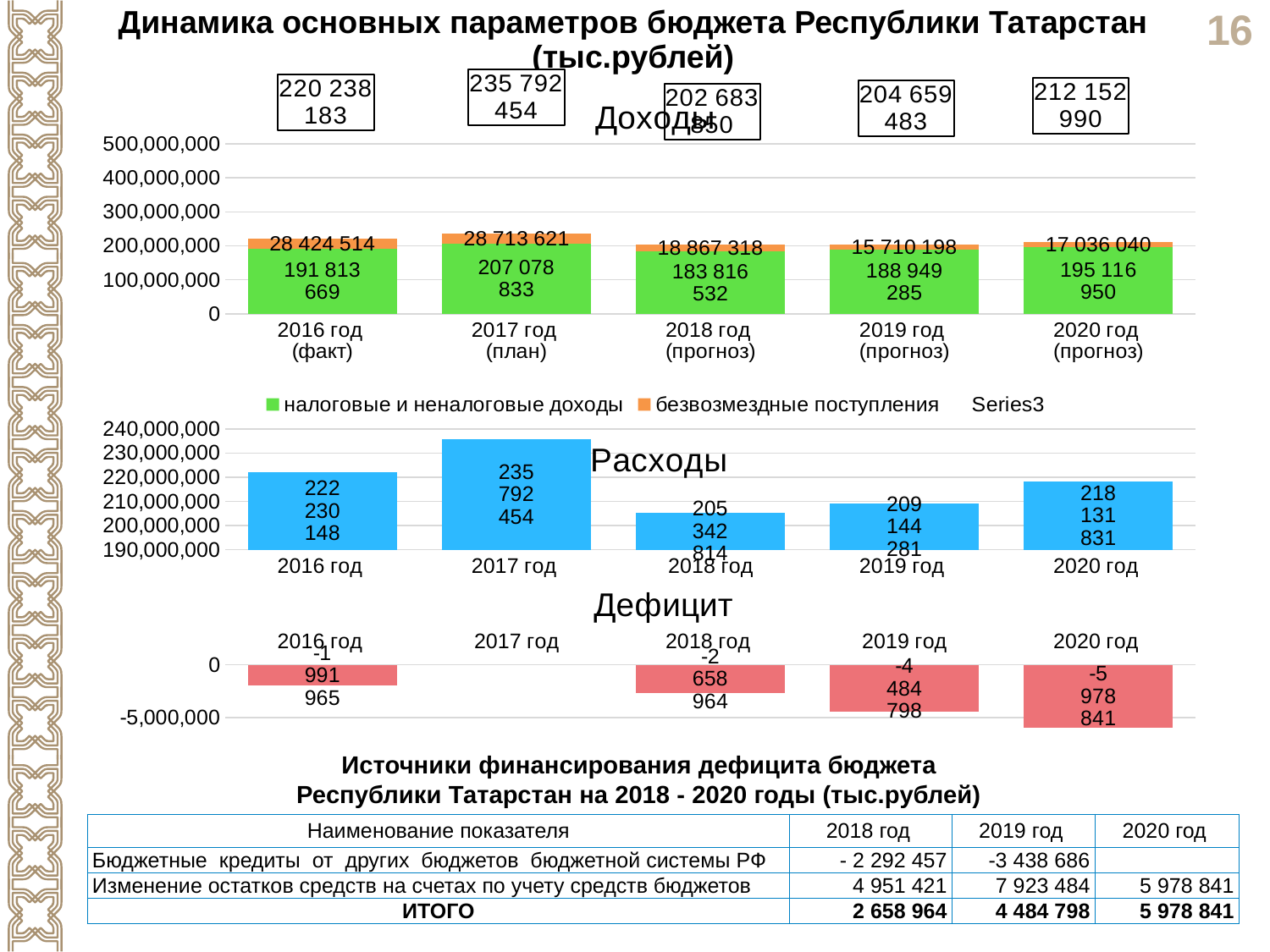
In the Доходы chart, what is the value of безвозмездные поступления for 2019 год (прогноз)? 15 710 198 In the Доходы chart, what is the value of налоговые и неналоговые доходы for 2017 год (план)? 207 078 833 In the Расходы chart, what is the value for 2018 год? 205 342 814 In the Расходы chart, which year has the highest value? 2017 год In the Дефицит chart, what is the value for 2020 год? -5 978 841 In the Доходы chart, what is the difference between налоговые и неналоговые доходы for 2020 год (прогноз) and 2019 год (прогноз)? 6 167 665 In the Доходы chart, which year has the highest безвозмездные поступления? 2017 год (план) In the Доходы chart, what is the total of the stacked bar for 2016 год (факт)? 220 238 183 What kind of chart is the Дефицит chart? bar chart In the Расходы chart, which year has the lowest value? 2018 год How many series does the legend of the Доходы chart list? 3 In the Доходы chart, which year has the lowest безвозмездные поступления? 2019 год (прогноз)